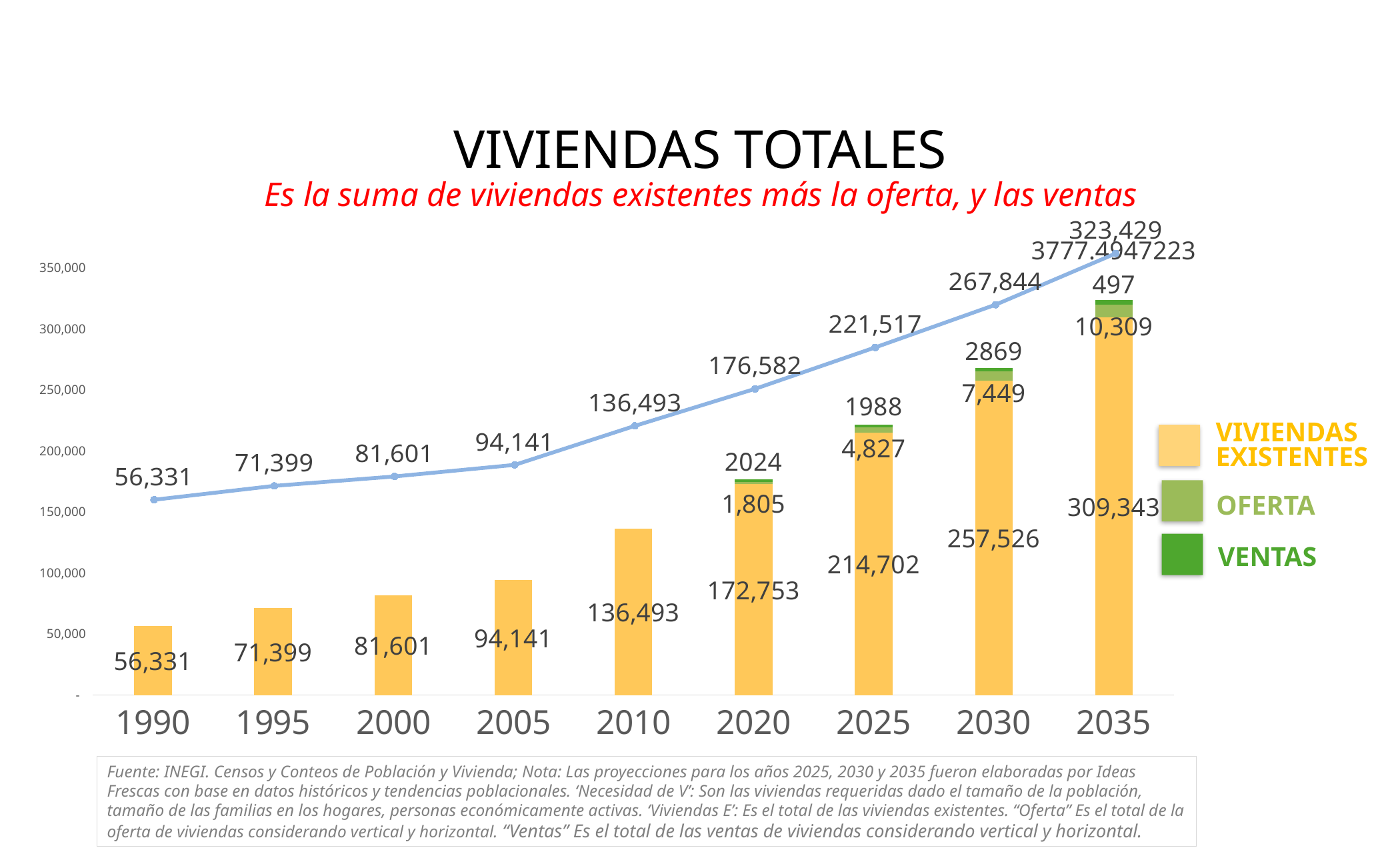
What is the Oferta value for 2030? 7,449 What total value does the line show for 2025? 221,517 Which year has the lowest Viviendas Existentes value? 1990 How many series does the legend list? 3 What is the difference between the Viviendas Existentes values for 2030 and 2025? 42,824 What is the Ventas value for 2020? 2024 How many years are shown on the x axis? 9 Which is larger, the Oferta value for 2025 or the Oferta value for 2035? 2035 Which year has the highest Viviendas Existentes value? 2035 What is the value of Viviendas Existentes for 2035? 309,343 Do the Viviendas Existentes values rise or fall from 1990 to 2035? rise Is the Viviendas Existentes bar for 2010 greater or less than 150,000? less